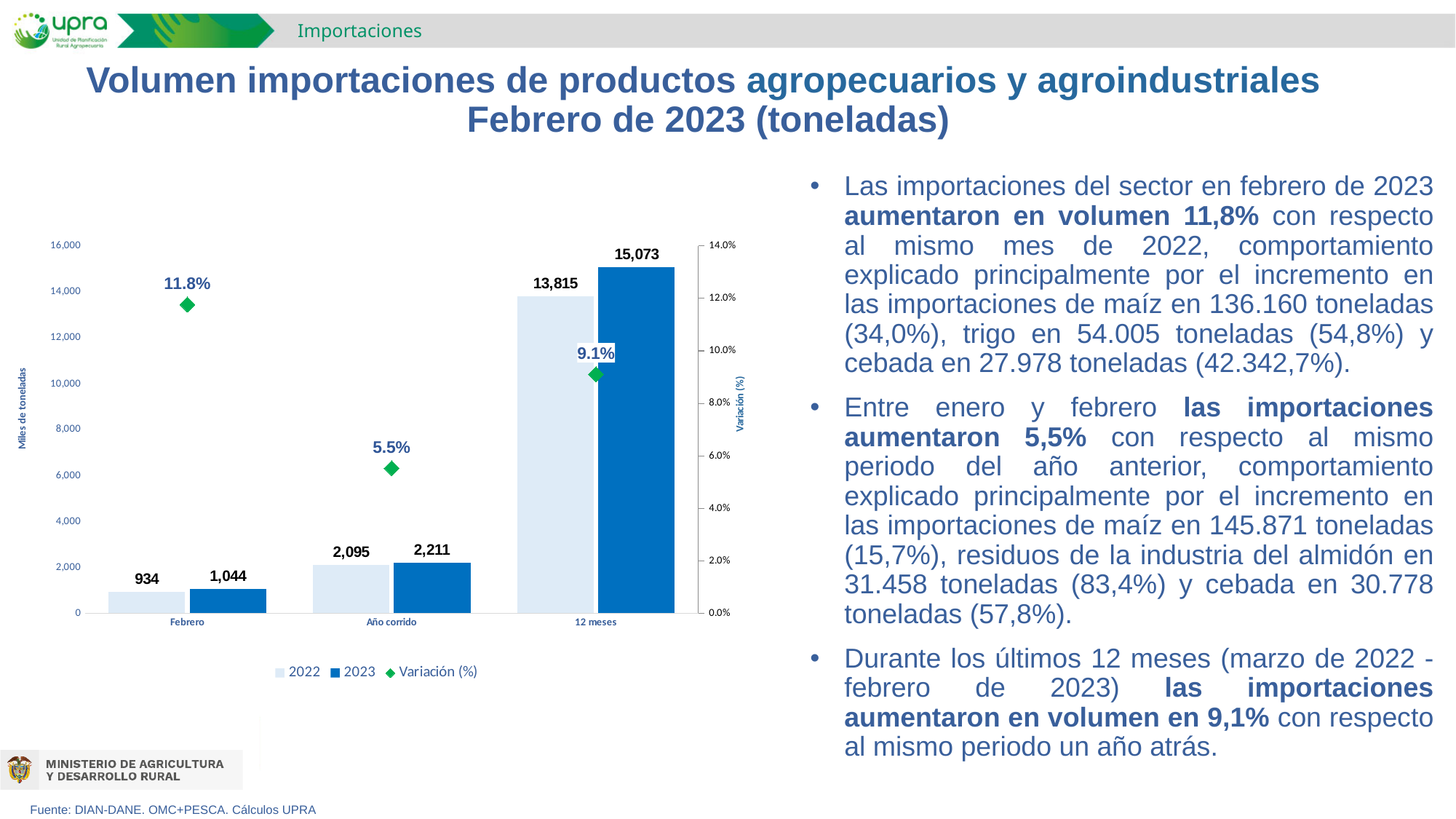
Which category has the highest 2023 value? 12 meses What is the difference between the 2023 and 2022 values for 12 meses? 1,258 How many categories are shown on the x axis? 3 What is the label of the left vertical axis? Miles de toneladas What kind of chart is this? Bar chart with a line/marker series How many series does the legend list? 3 What is the Variación (%) value for Año corrido? 5.5% What is the 2022 value for 12 meses? 13,815 Which is larger for Año corrido, the 2022 value or the 2023 value? 2023 What is the 2023 value for Febrero? 1,044 Which category has the lowest 2022 value? Febrero Which category has the highest Variación (%)? Febrero